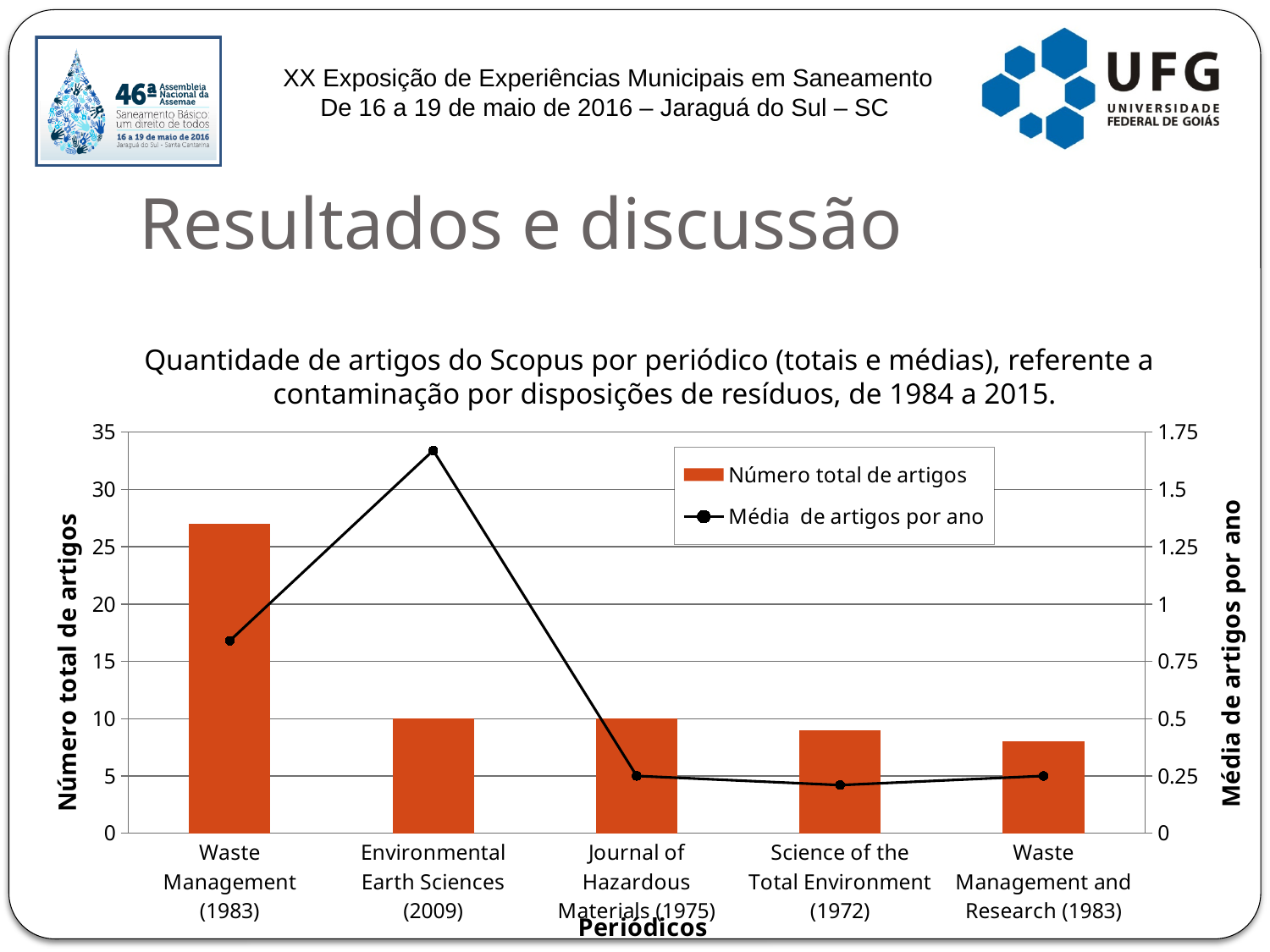
What is the 'Número total de artigos' for Environmental Earth Sciences (2009)? 10 Is the 'Média de artigos por ano' for Environmental Earth Sciences (2009) greater or less than 1.5? greater Which periodical has the lowest 'Número total de artigos'? Waste Management and Research (1983) What is the title of the left vertical axis? Número total de artigos How many series does the legend list? 2 Which has a larger 'Número total de artigos': Waste Management (1983) or Science of the Total Environment (1972)? Waste Management (1983) Is the 'Número total de artigos' for Waste Management (1983) greater or less than 25? greater What kind of chart is shown on the slide? A combined bar and line chart What are the two entries listed in the chart legend? Número total de artigos; Média de artigos por ano How many periodicals (categories) are shown on the x axis? 5 Which periodical has the highest 'Número total de artigos'? Waste Management (1983) Which periodical has the highest 'Média de artigos por ano'? Environmental Earth Sciences (2009)